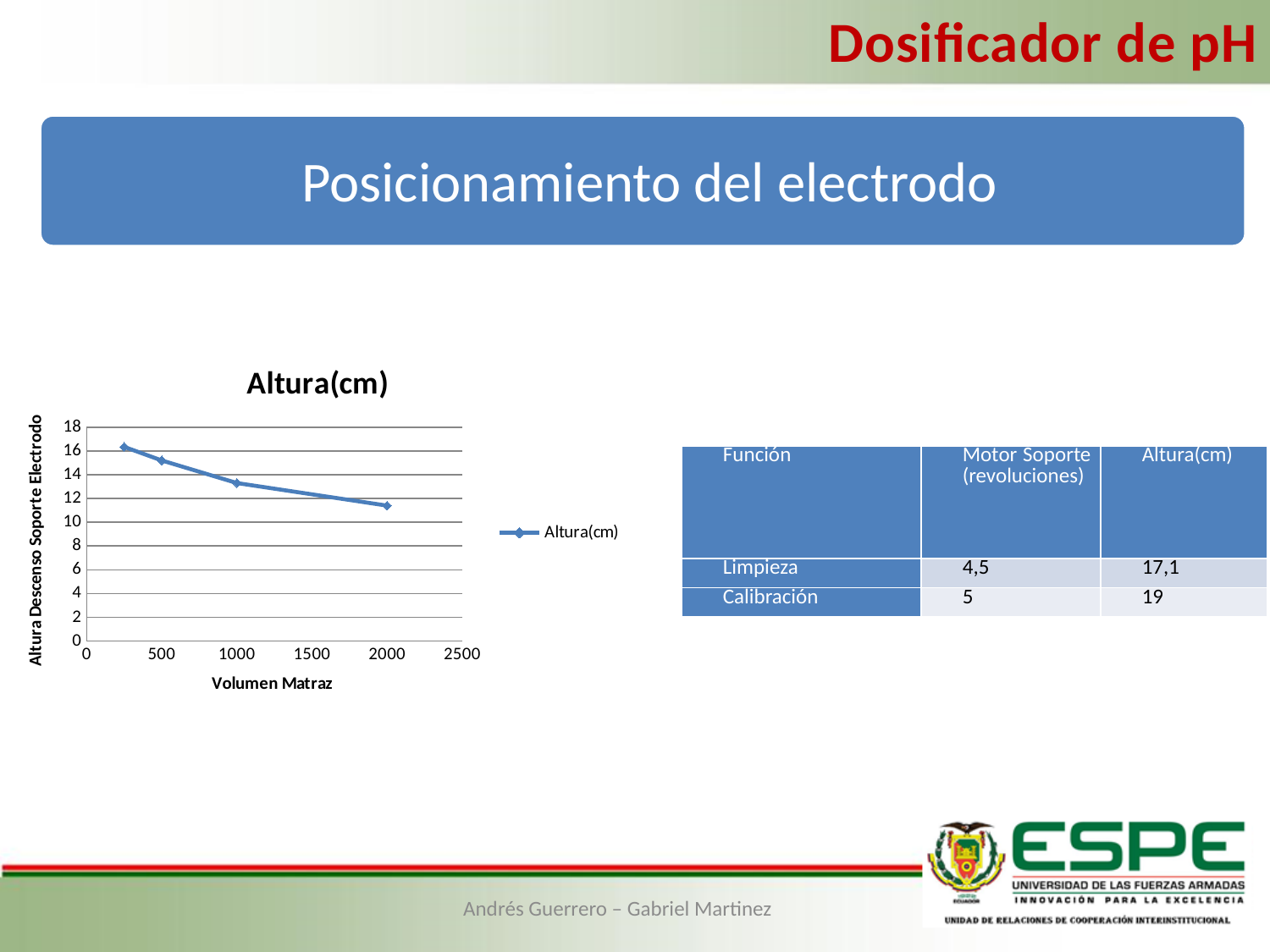
Is the value at Volumen Matraz 500 greater or less than 14? greater How many data points are plotted on the line? 4 What kind of chart is shown on the slide? line chart What is the x-axis title of the chart? Volumen Matraz What is the title of the chart? Altura(cm) Is the value at Volumen Matraz 2000 greater or less than 12? less Is the value at Volumen Matraz 1000 greater or less than 12? greater At which Volumen Matraz value is the plotted Altura lowest? 2000 Which is larger, the value at Volumen Matraz 500 or at 2000? 500 Do the values rise or fall as Volumen Matraz increases along the x axis? fall How many series does the chart legend list? 1